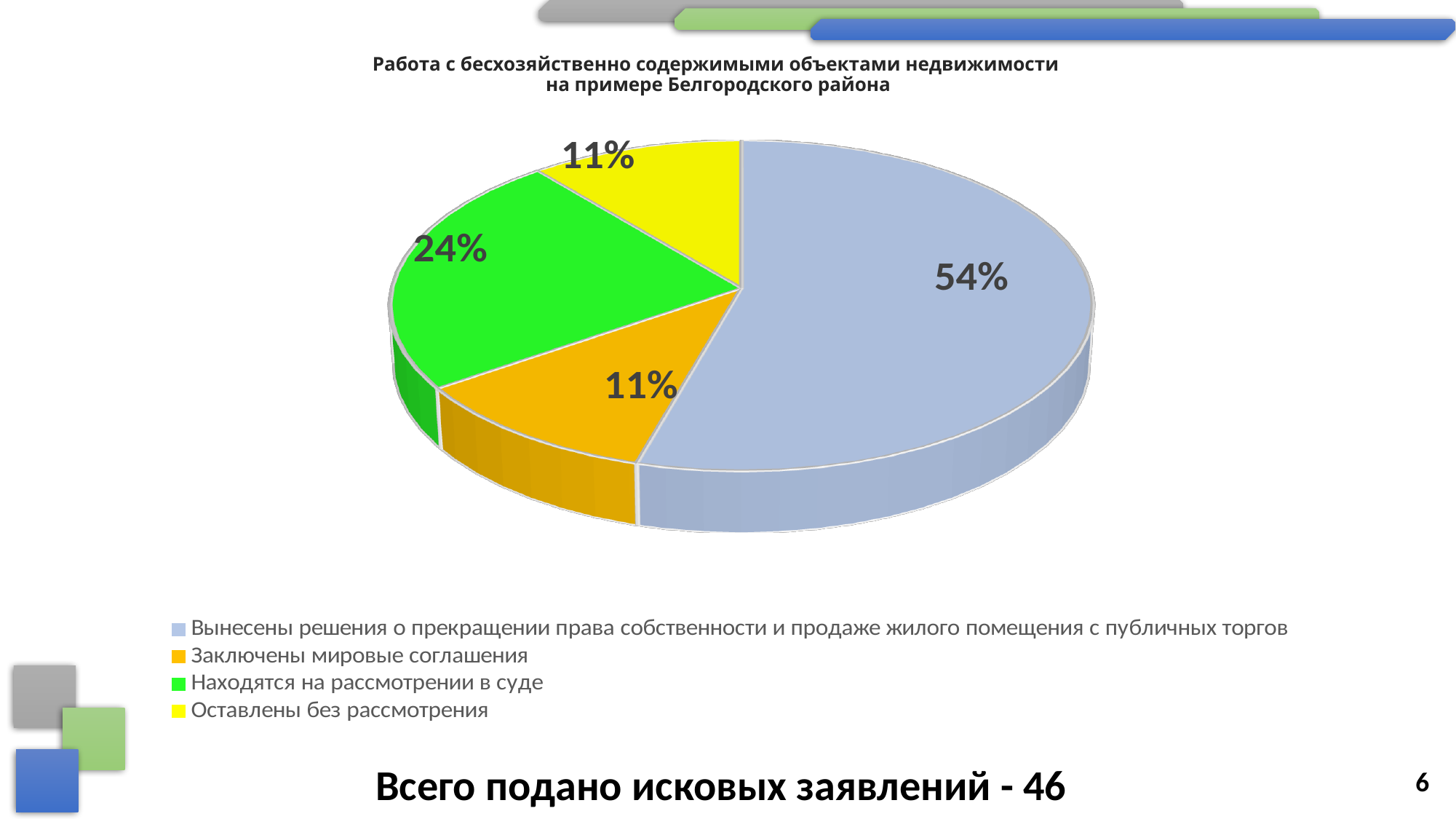
What share of the pie is labelled "Вынесены решения о прекращении права собственности и продаже жилого помещения с публичных торгов"? 54% Which is larger: the share for "Находятся на рассмотрении в суде" or the share for "Заключены мировые соглашения"? Находятся на рассмотрении в суде What colour is the slice for "Находятся на рассмотрении в суде"? green What share of the pie is labelled "Оставлены без рассмотрения"? 11% How many slices does the pie chart have? 4 What is the difference in percentage points between the "Вынесены решения..." slice and the "Находятся на рассмотрении в суде" slice? 30 percentage points What kind of chart is shown on the slide? pie chart Which two categories share the smallest slice of the pie? Заключены мировые соглашения and Оставлены без рассмотрения What share of the pie is labelled "Заключены мировые соглашения"? 11% According to the text below the chart, how many claims were filed in total (Всего подано исковых заявлений)? 46 Which category has the largest share of the pie? Вынесены решения о прекращении права собственности и продаже жилого помещения с публичных торгов